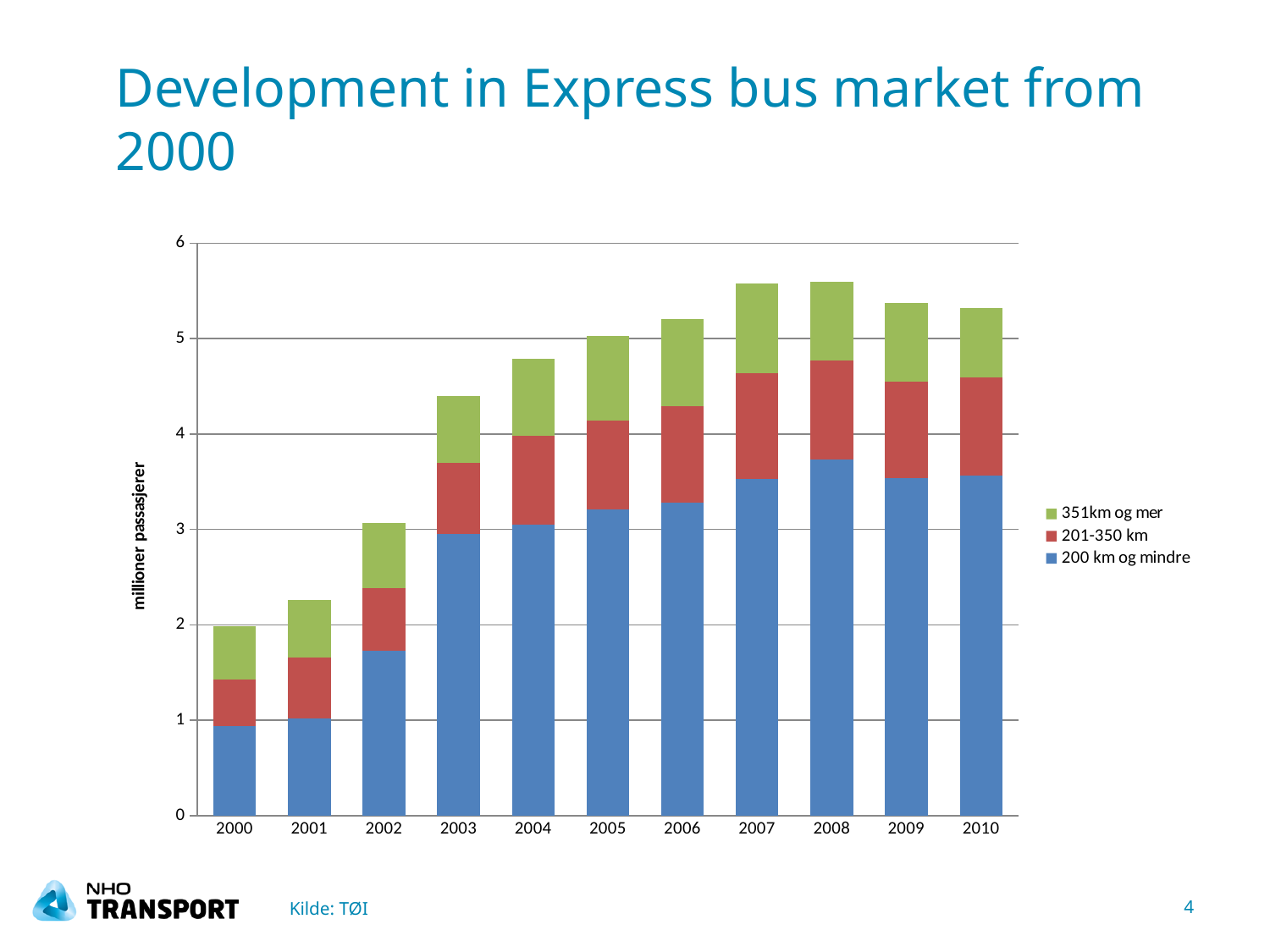
Which year has the lowest total bar in the chart? 2000 Is the value of the '200 km og mindre' segment for 2002 greater or less than 2? less What is the label on the y axis of the chart? millioner passasjerer Do the total bars generally rise or fall from 2000 to 2008? rise How many series does the chart's legend list? 3 What kind of chart is shown on the slide? Stacked bar chart Is the value of the '200 km og mindre' segment for 2007 greater or less than 3? greater Which year has the larger total bar, 2002 or 2003? 2003 Is the total bar for 2006 greater or less than 5? greater How many years are shown on the x axis of the chart? 11